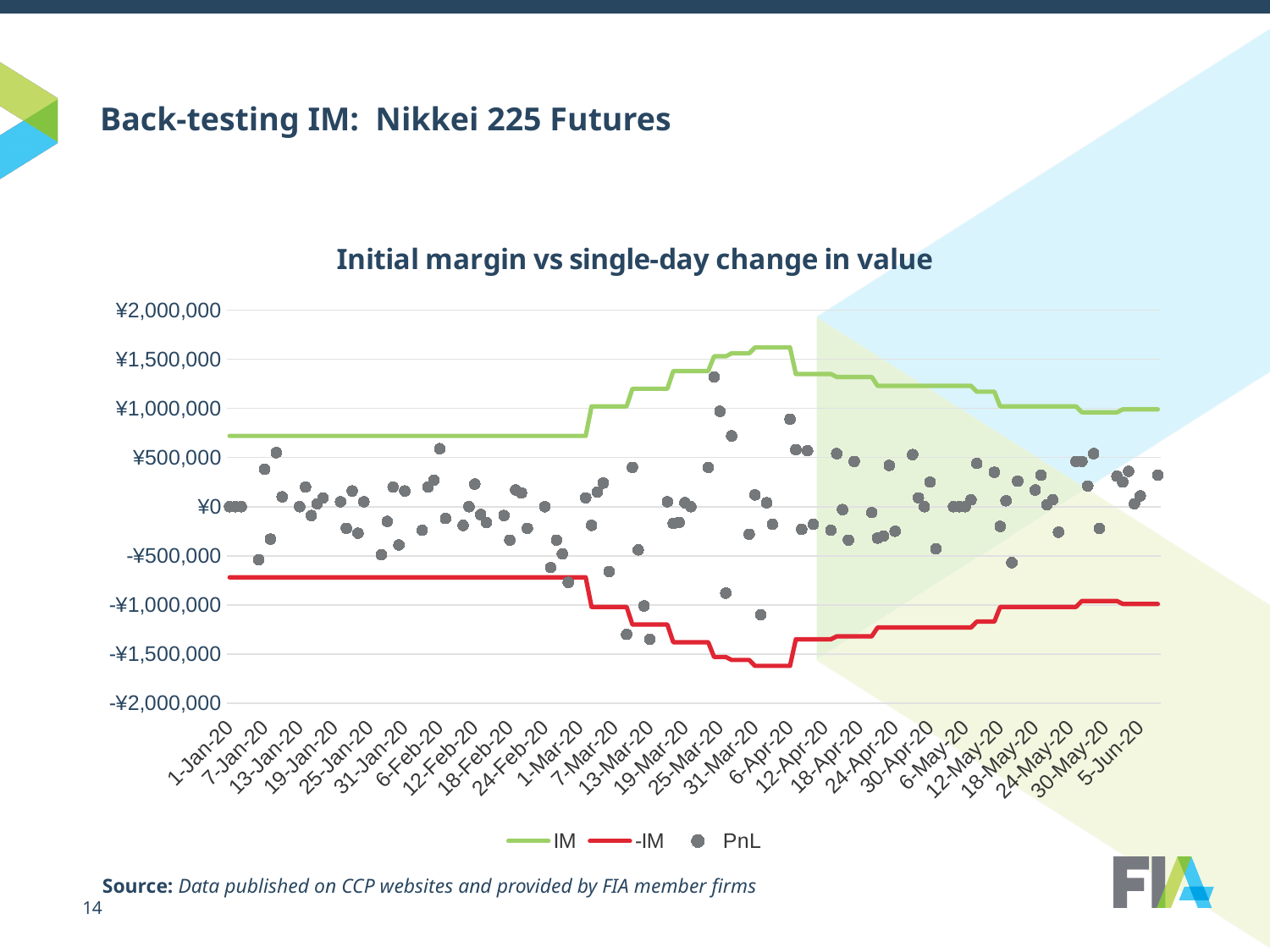
Is the -IM value on 1-Jan-20 greater or less than -¥500,000? less How many date labels are shown on the x axis? 27 Is the highest value reached by the IM line greater or less than ¥1,500,000? greater Which series has the highest values on the chart, IM or -IM? IM How many series does the chart legend list? 3 Which series in the legend is plotted as dots rather than a line? PnL Is the IM value on 5-Jun-20 greater or less than ¥1,500,000? less What is the title of the chart? Initial margin vs single-day change in value Does the IM line rise or fall between 1-Jan-20 and 31-Mar-20? rise Does the IM line rise or fall between 6-Apr-20 and 5-Jun-20? fall